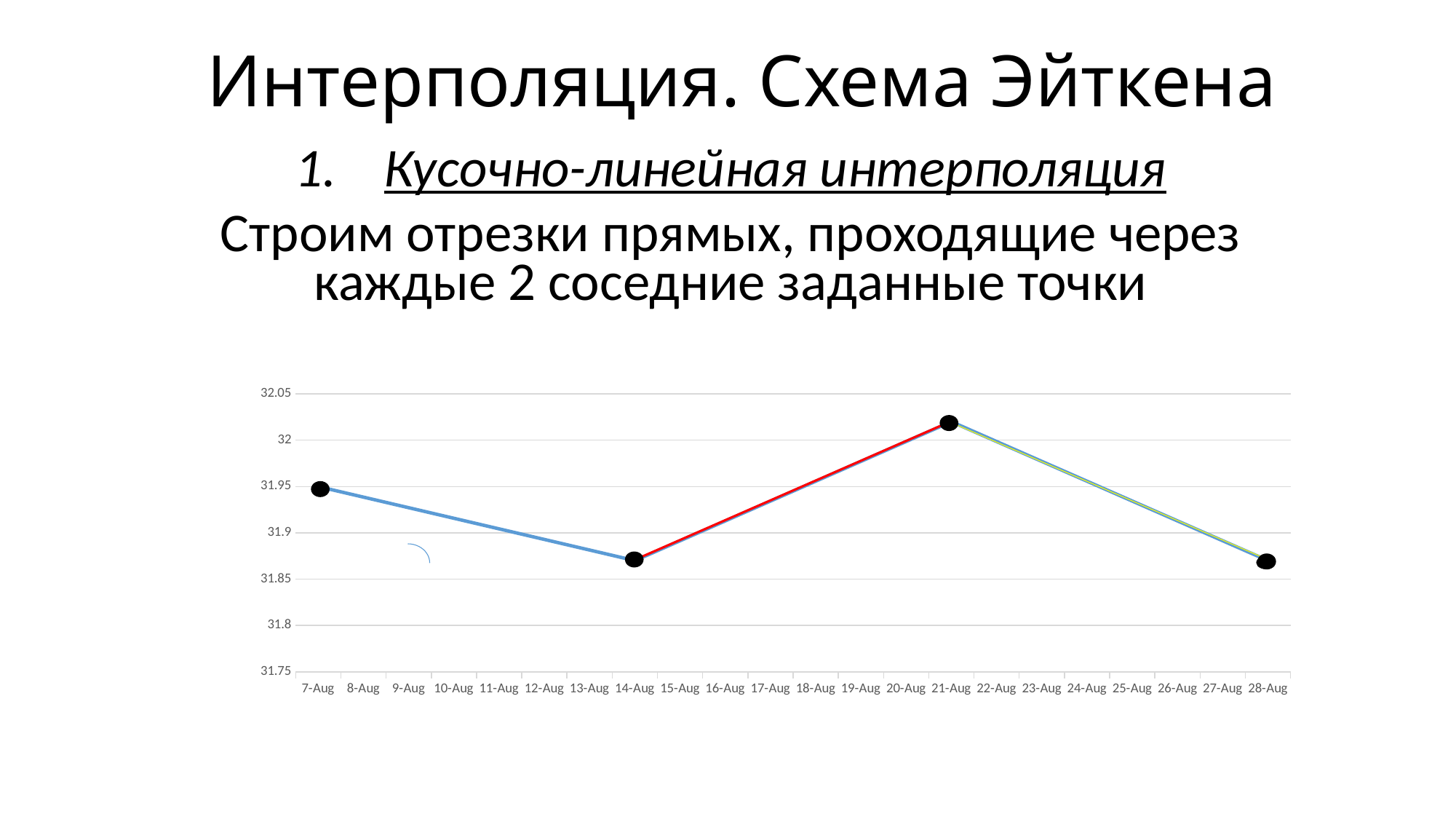
How many date labels are shown along the x axis? 22 Does the line rise or fall between 14-Aug and 21-Aug? rises Is the value at 7-Aug greater or less than 31.9? greater Which is larger, the value at 7-Aug or the value at 14-Aug? 7-Aug What colour is the line segment between 14-Aug and 21-Aug? red How many marked data points (black dots) are on the chart? 4 Is the value at 21-Aug greater or less than 32? greater Is the value at 14-Aug greater or less than 31.9? less Does the line rise or fall between 21-Aug and 28-Aug? falls What kind of chart is shown on the slide? line chart At which date does the line reach its highest value? 21-Aug